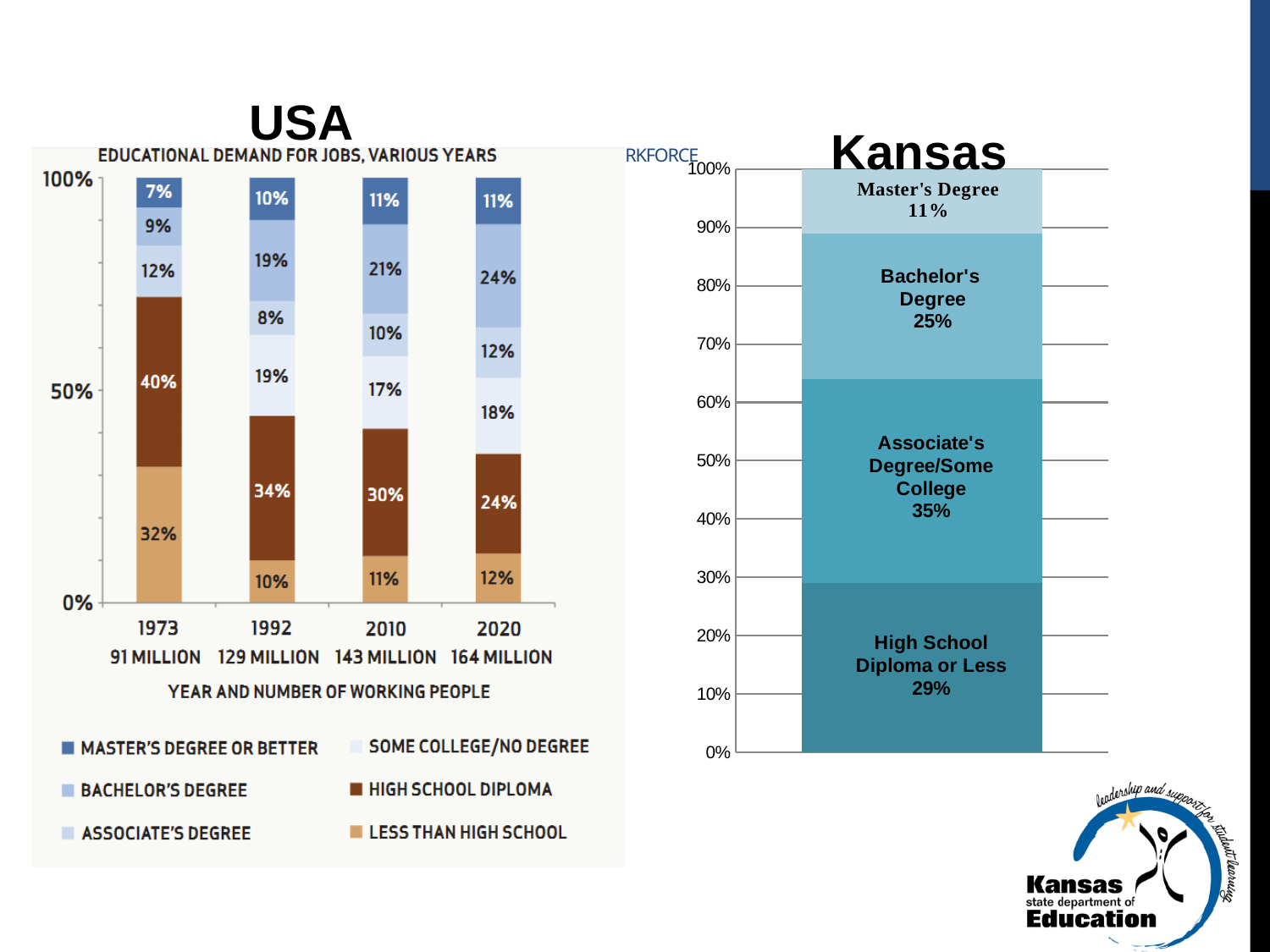
What type of chart is the Kansas chart? Stacked bar chart In the USA chart, what is the Master's Degree or Better share for 2020? 11% In the Kansas chart, which education level has the smallest share? Master's Degree In the Kansas chart, which education level has the largest share? Associate's Degree/Some College In the USA chart, which year has the larger High School Diploma share, 1992 or 2010? 1992 In the USA chart, what percentage of jobs in 1973 required a high school diploma? 40% In the USA chart, how many years are shown on the x axis? 4 In the Kansas chart, what percentage is shown for Associate's Degree/Some College? 35% In the USA chart, how many education categories does the legend list? 6 In the USA chart, does the Bachelor's Degree share rise or fall from 1973 to 2020? Rise In the USA chart, by how many percentage points does the Less Than High School share in 1973 exceed that in 2020? 20 percentage points In the USA chart, how many working people are listed for 2020? 164 million